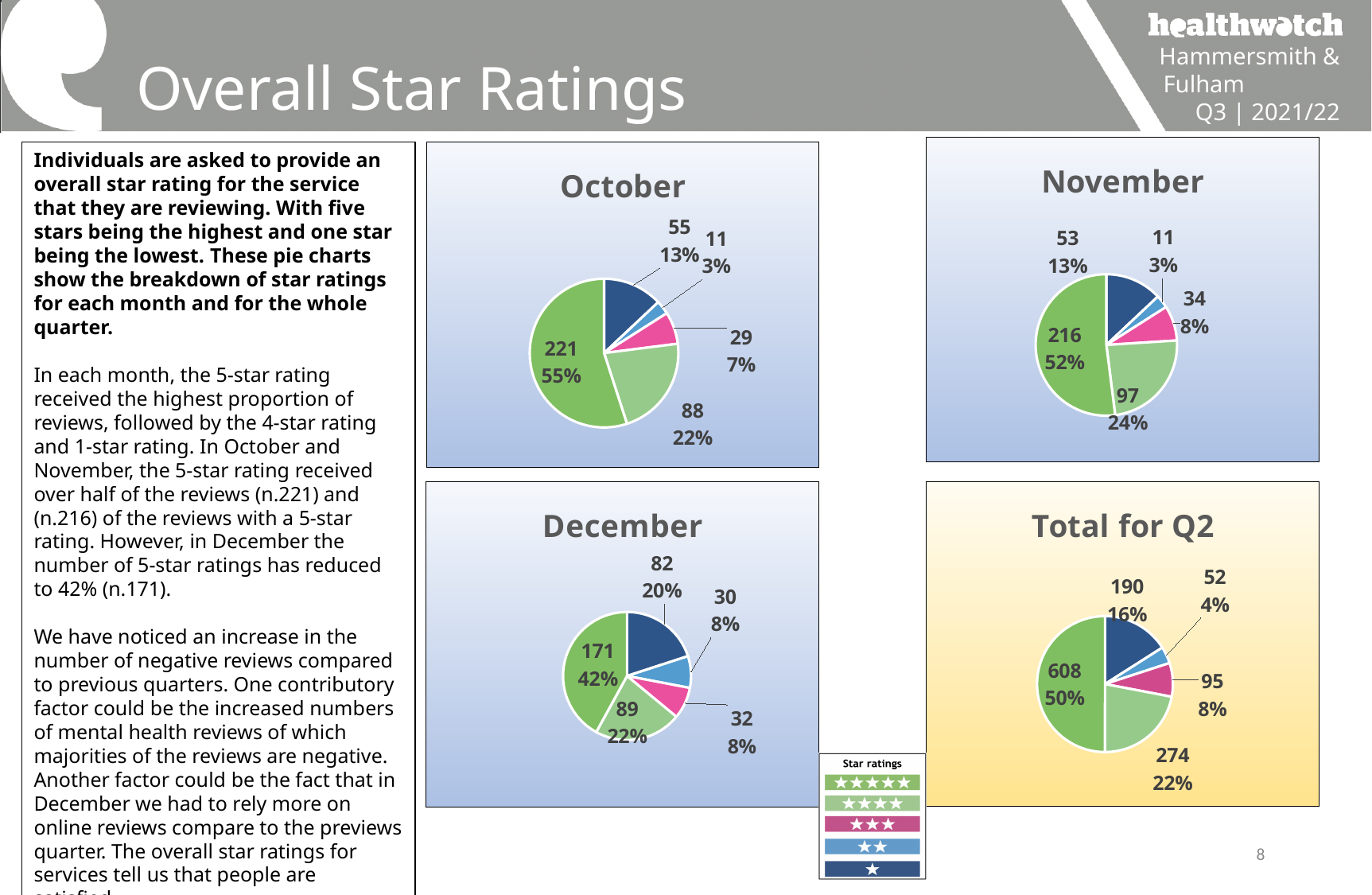
In the October pie chart, which star rating has the smallest slice? 2 stars How many slices does the November pie chart have? 5 In the Total for Q2 pie chart, which is larger: the number of 1-star reviews or the number of 3-star reviews? 1-star reviews In the Total for Q2 pie chart, what share of reviews gave a 5-star rating? 50% What is the title of the pie chart in the bottom right of the slide? Total for Q2 How many star-rating categories does the legend list? 5 What type of chart is used to show the December star ratings? Pie chart In the November pie chart, what percentage of reviews gave a 4-star rating? 24% What is the difference between the number of 5-star reviews in October and in December? 50 In the October pie chart, how many reviews gave a 5-star rating? 221 In the December pie chart, how many reviews gave a 1-star rating? 82 In the December pie chart, which star rating has the largest slice? 5 stars